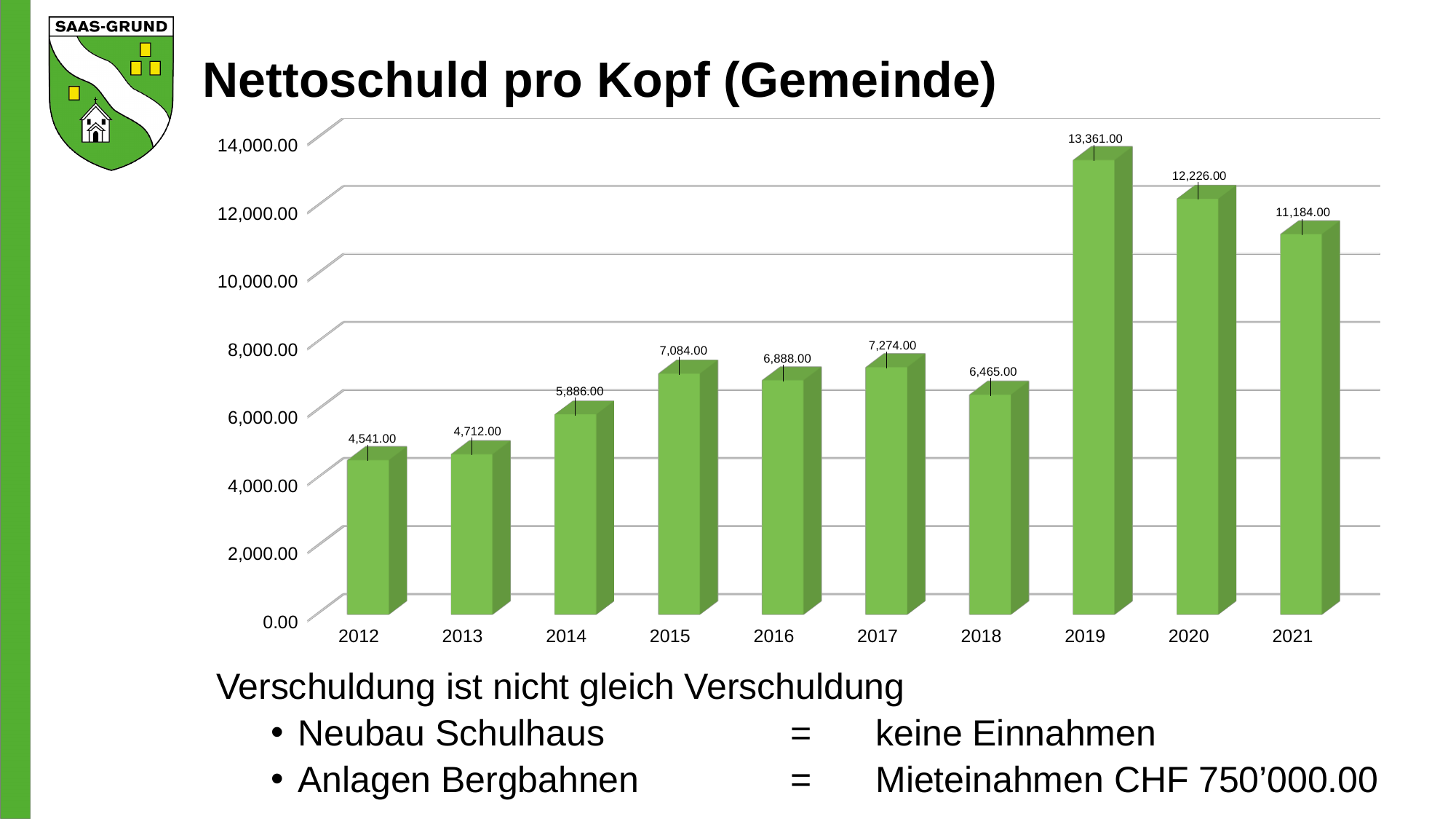
What is the difference between the values for 2020 and 2021? 1,042.00 What is the value for 2019? 13,361.00 Which is larger, the value for 2015 or the value for 2016? 2015 What is the difference between the values for 2019 and 2018? 6,896.00 Which year has the highest value? 2019 What is the value for 2012? 4,541.00 What kind of chart is shown on the slide? bar chart Which year has the lowest value? 2012 How many years are shown on the x axis? 10 What is the value for 2018? 6,465.00 Is the value for 2021 greater or less than 10,000.00? greater What is the title of the chart? Nettoschuld pro Kopf (Gemeinde)